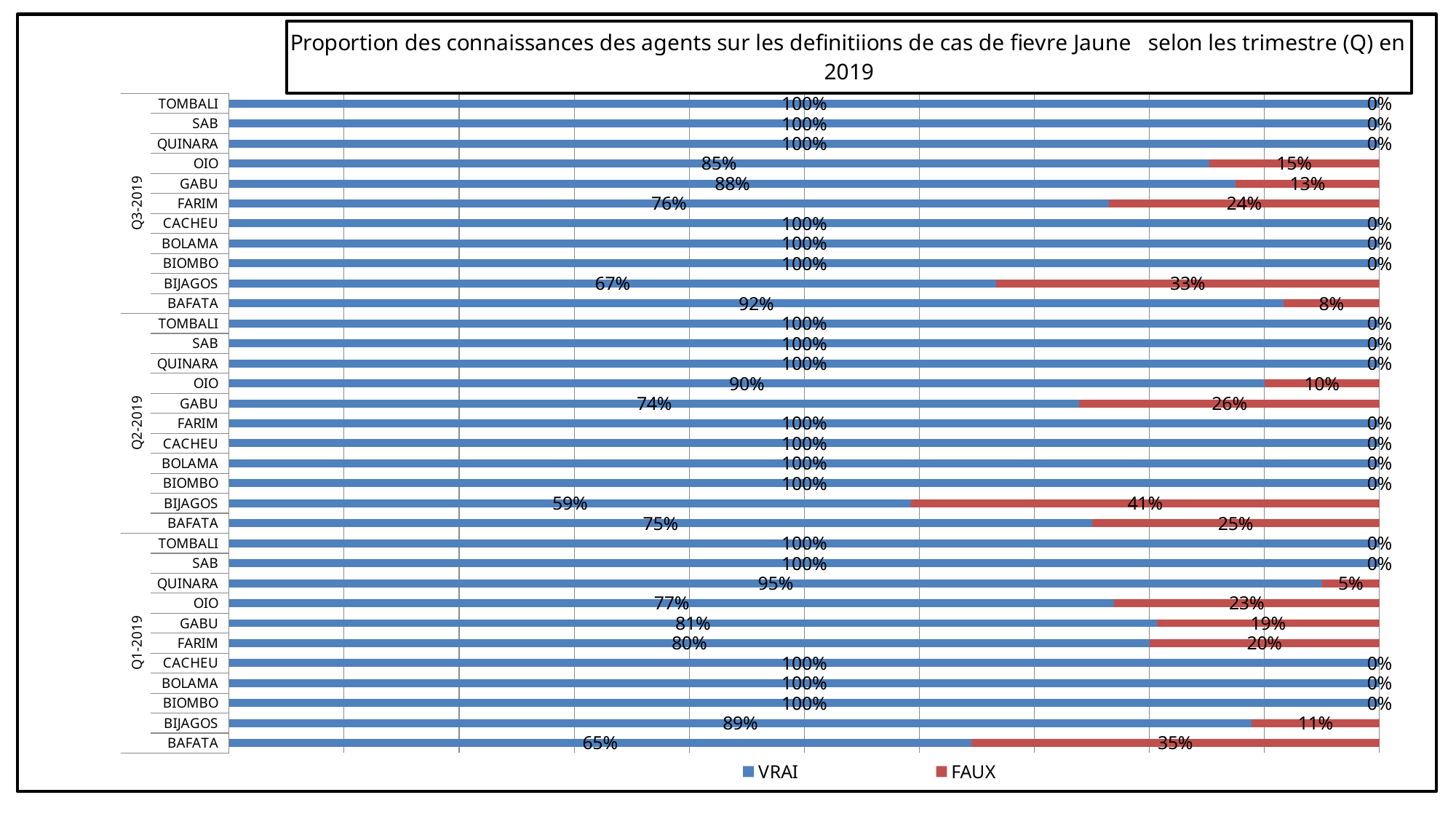
How many series does the legend list? 2 What is the VRAI value for FARIM in Q3-2019? 76% Which region has the lowest VRAI value in Q2-2019? BIJAGOS What is the difference between the VRAI values for BAFATA in Q3-2019 and Q1-2019? 27% Which colour represents the FAUX series in the legend? Red Which region has the highest FAUX value in Q1-2019? BAFATA What kind of chart is shown on the slide? Stacked bar chart What is the FAUX value for GABU in Q2-2019? 26% What is the VRAI value for BIJAGOS in Q2-2019? 59% How many regions are listed within each quarter? 11 Which is larger, the FAUX value for OIO in Q1-2019 or the FAUX value for OIO in Q3-2019? OIO in Q1-2019 What is the FAUX value for BAFATA in Q1-2019? 35%